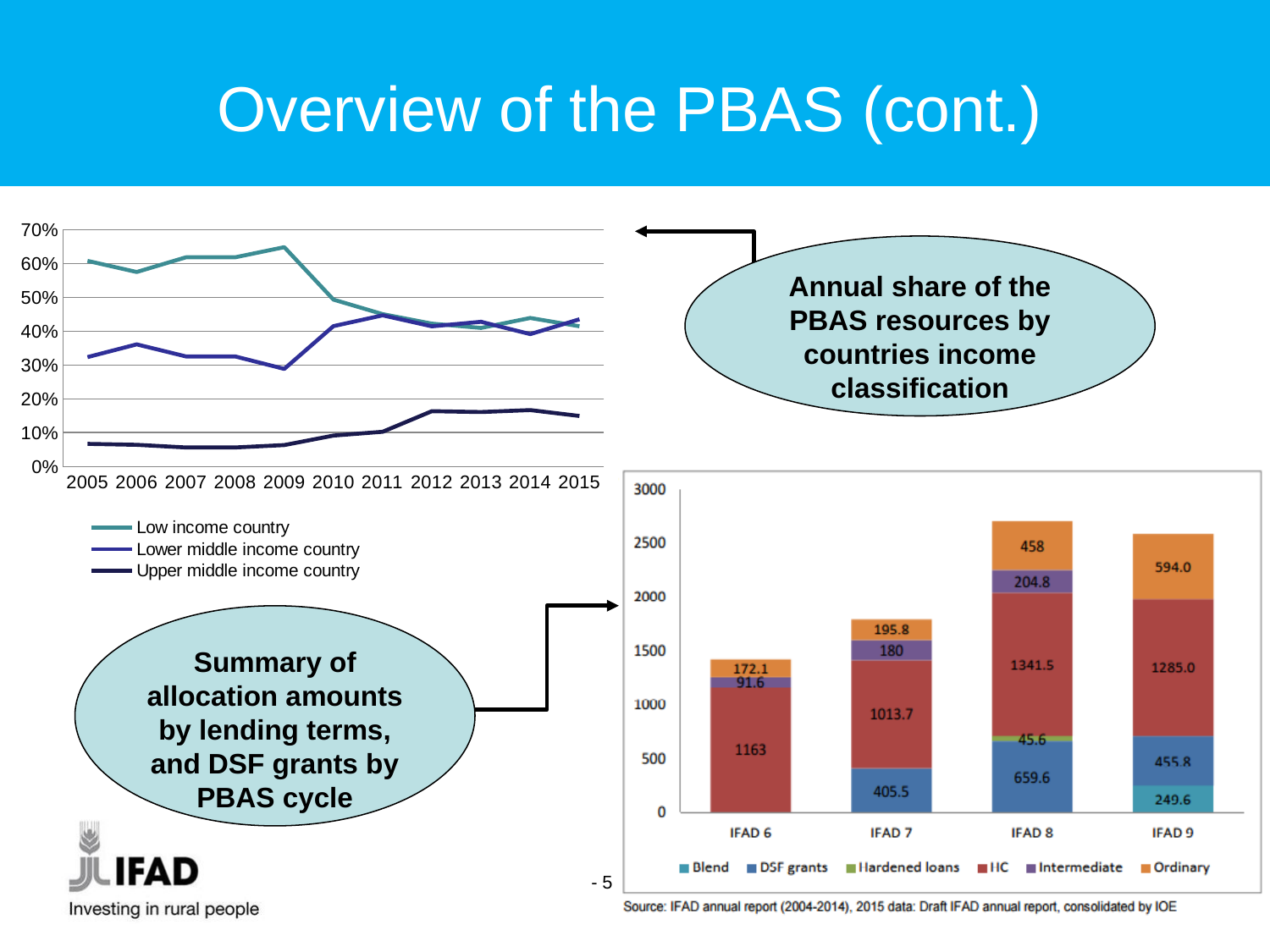
In the top-left line chart, is the value for Upper middle income country in 2005 greater or less than 10%? less In the top-left line chart, how many series does the legend list? 3 In the bottom-right stacked bar chart, what is the Ordinary value for IFAD 9? 594.0 In the bottom-right stacked bar chart, what is the difference between the HC values for IFAD 8 and IFAD 9? 56.5 What kind of chart is the top-left chart showing the annual share of PBAS resources by country income classification? line chart In the top-left line chart, does the Upper middle income country share rise or fall from 2005 to 2015? rise In the top-left line chart, how many years are shown on the x axis? 11 In the bottom-right stacked bar chart, what is the total of the IFAD 7 bar? 1795 In the top-left line chart, which income classification has the highest share in 2005? Low income country In the bottom-right stacked bar chart, how many series does the legend list? 6 In the top-left line chart, is the value for Low income country in 2009 greater or less than 60%? greater In the bottom-right stacked bar chart, what is the HC value for IFAD 8? 1341.5